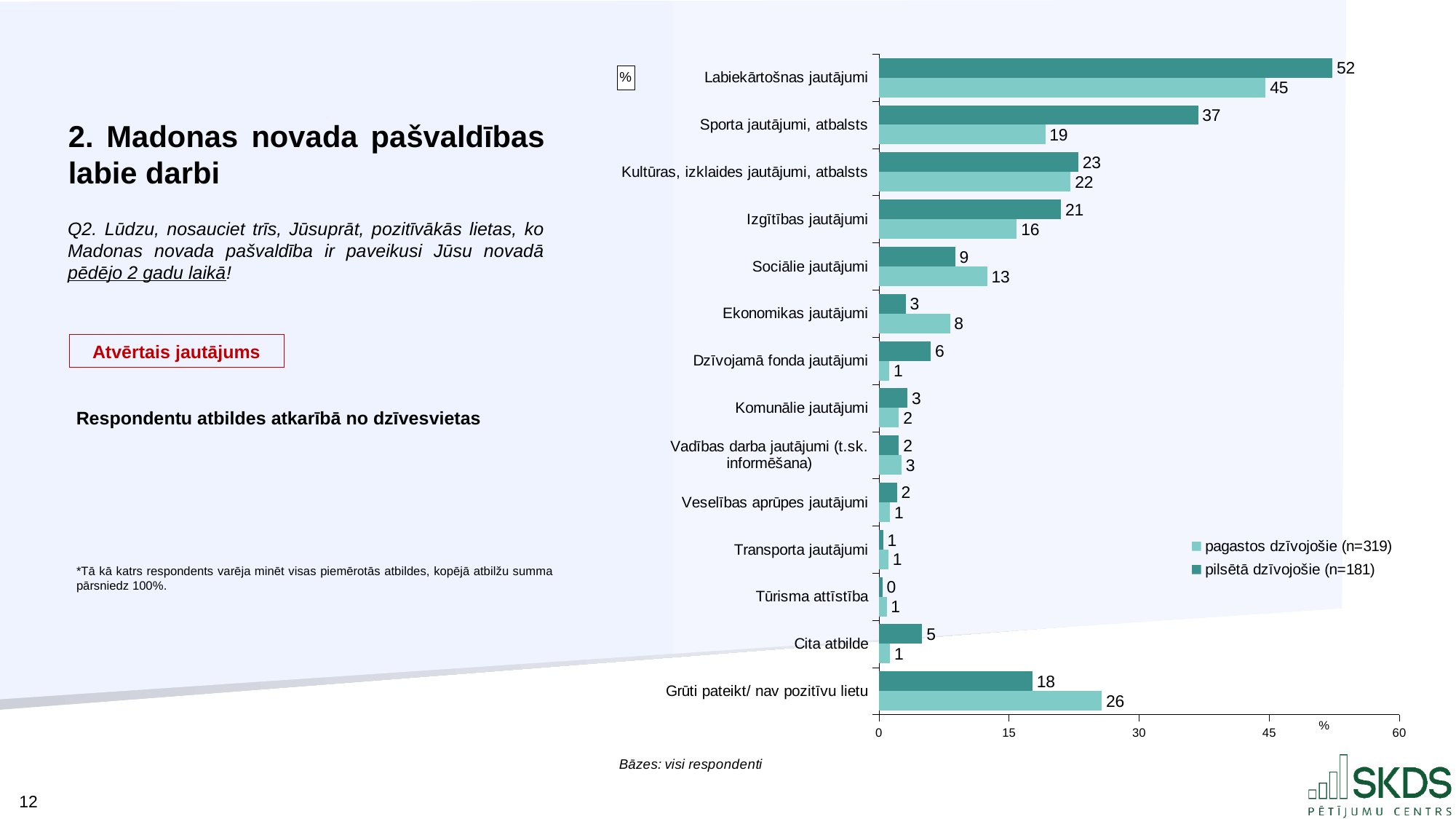
Which category has the lowest value for 'pilsētā dzīvojošie (n=181)'? Tūrisma attīstība What is the sample size (n) given in the legend for 'pagastos dzīvojošie'? 319 Is the value for 'pilsētā dzīvojošie (n=181)' for 'Labiekārtošnas jautājumi' greater or less than 45? greater How many categories are shown on the chart? 14 For 'Sociālie jautājumi', which series has the larger value: 'pagastos dzīvojošie (n=319)' or 'pilsētā dzīvojošie (n=181)'? pagastos dzīvojošie (n=319) How many series does the legend list? 2 What is the value for 'pagastos dzīvojošie (n=319)' for 'Grūti pateikt/ nav pozitīvu lietu'? 26 What is the difference between the 'pilsētā dzīvojošie (n=181)' and 'pagastos dzīvojošie (n=319)' values for 'Sporta jautājumi, atbalsts'? 18 What is the value for 'pilsētā dzīvojošie (n=181)' for 'Labiekārtošnas jautājumi'? 52 Which category has the highest value for 'pilsētā dzīvojošie (n=181)'? Labiekārtošnas jautājumi What is the value for 'pagastos dzīvojošie (n=319)' for 'Sporta jautājumi, atbalsts'? 19 What kind of chart is shown on the slide? bar chart